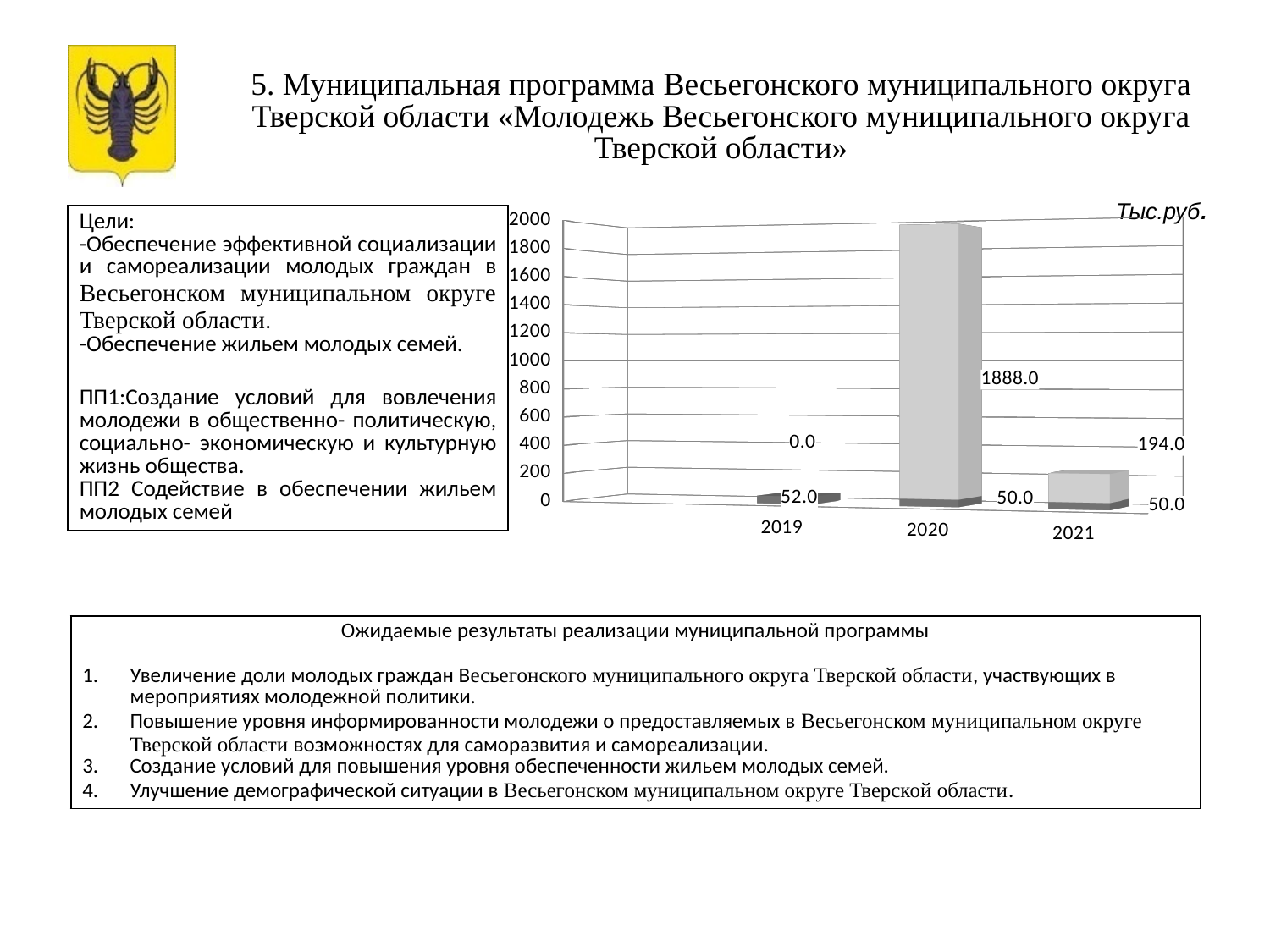
What is the difference between the light grey bar values for 2020 and 2021? 1694.0 What is the value of the light grey bar for 2020? 1888.0 What is the value of the light grey bar for 2021? 194.0 Which is larger: the dark grey bar for 2019 or the dark grey bar for 2020? 2019 What is the value of the dark grey bar for 2019? 52.0 How many years are shown on the x axis of the chart? 3 What is the sum of the two bar values shown for 2021? 244.0 What is the value of the light grey bar for 2019? 0.0 What kind of chart is shown on the slide? bar chart Is the value of the light grey bar for 2020 greater or less than 1800? greater What unit label is printed at the top right of the chart? Тыс.руб. In which year is the light grey bar the highest? 2020